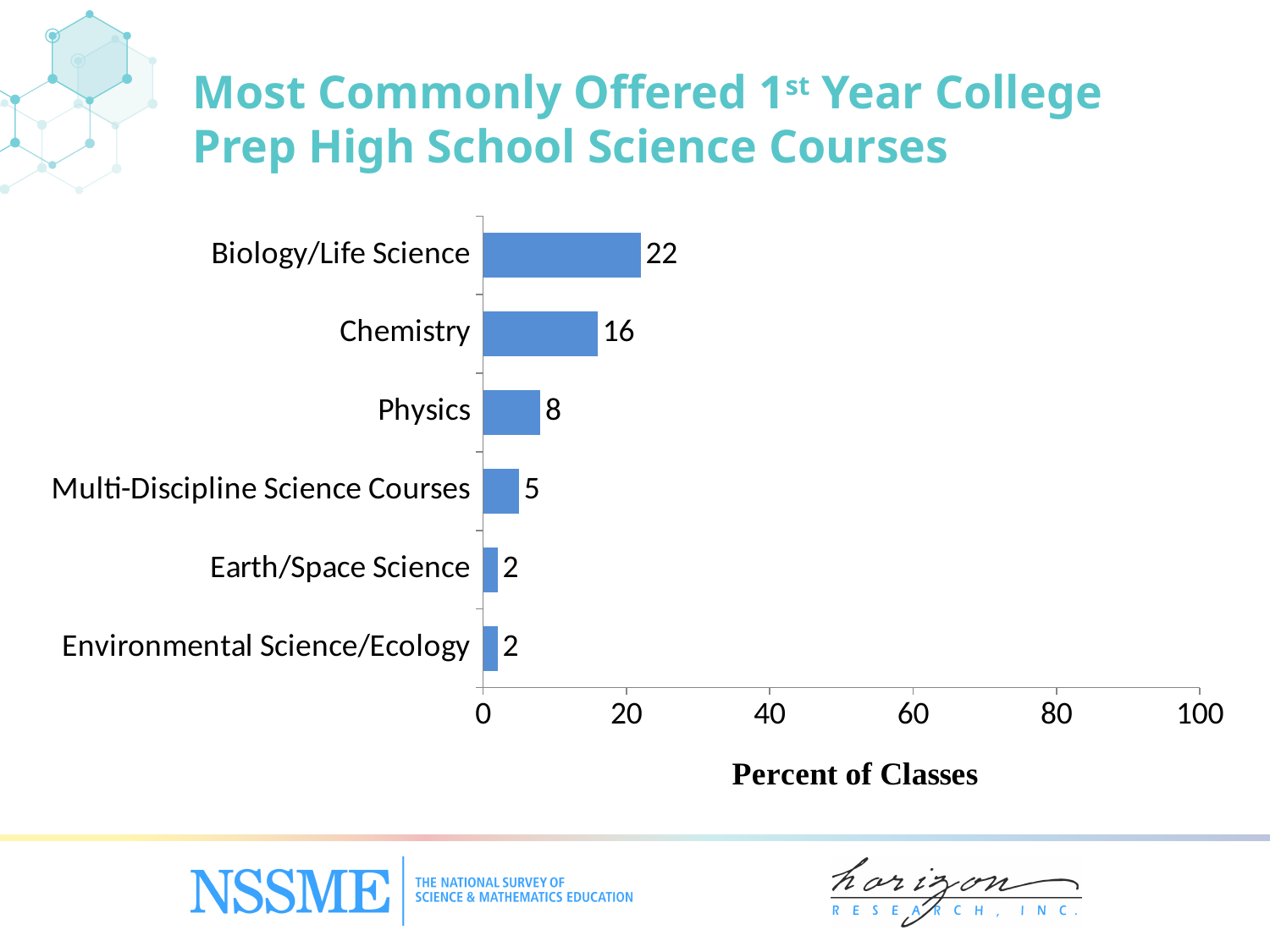
What is the value for Biology/Life Science? 22 What is the label of the horizontal axis? Percent of Classes How many categories are shown in the chart? 6 What is the value for Physics? 8 Is the value for Biology/Life Science greater or less than 20? greater What kind of chart is shown on the slide? bar chart Which is larger, the value for Physics or the value for Multi-Discipline Science Courses? Physics What is the difference between the values for Biology/Life Science and Chemistry? 6 What is the difference between the values for Chemistry and Physics? 8 What is the value for Multi-Discipline Science Courses? 5 What is the value for Chemistry? 16 Which category has the highest value? Biology/Life Science